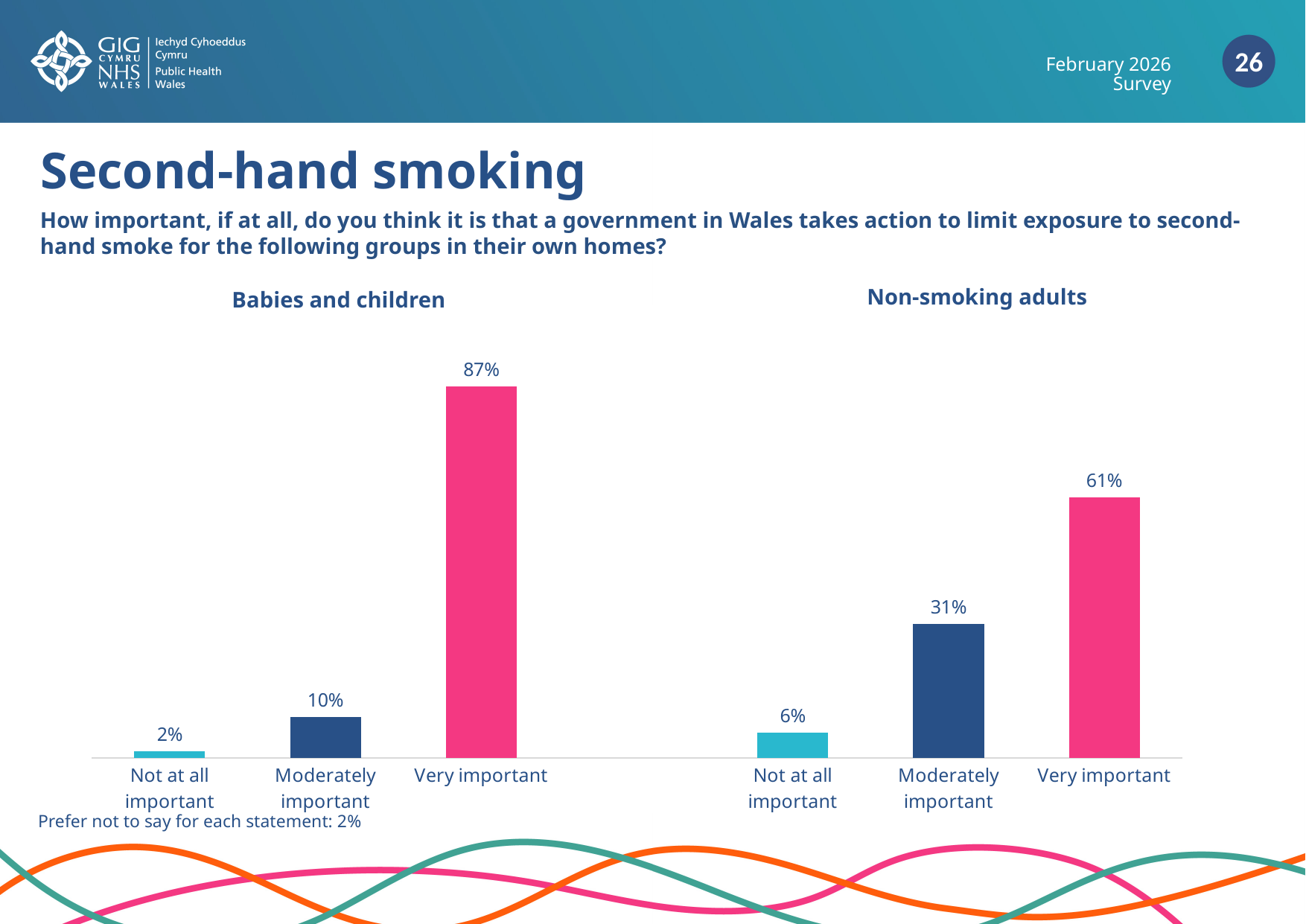
Which is larger: 'Moderately important' for 'Babies and children' or 'Moderately important' for 'Non-smoking adults'? Non-smoking adults In the 'Babies and children' chart, what percentage said 'Very important'? 87% What is the difference between the 'Very important' values in the 'Babies and children' chart and the 'Non-smoking adults' chart? 26 percentage points In the 'Non-smoking adults' chart, which category has the highest value? Very important In the 'Non-smoking adults' chart, do the values rise or fall from left to right? Rise In the 'Non-smoking adults' chart, what percentage said 'Moderately important'? 31% What colour is the 'Very important' bar in the 'Babies and children' chart? Pink In the 'Babies and children' chart, which category has the lowest value? Not at all important In the 'Non-smoking adults' chart, what percentage said 'Not at all important'? 6% How many categories are shown in the 'Non-smoking adults' chart? 3 In the 'Babies and children' chart, what is the difference between 'Moderately important' and 'Not at all important'? 8 percentage points What type of chart is used for 'Babies and children'? Bar chart